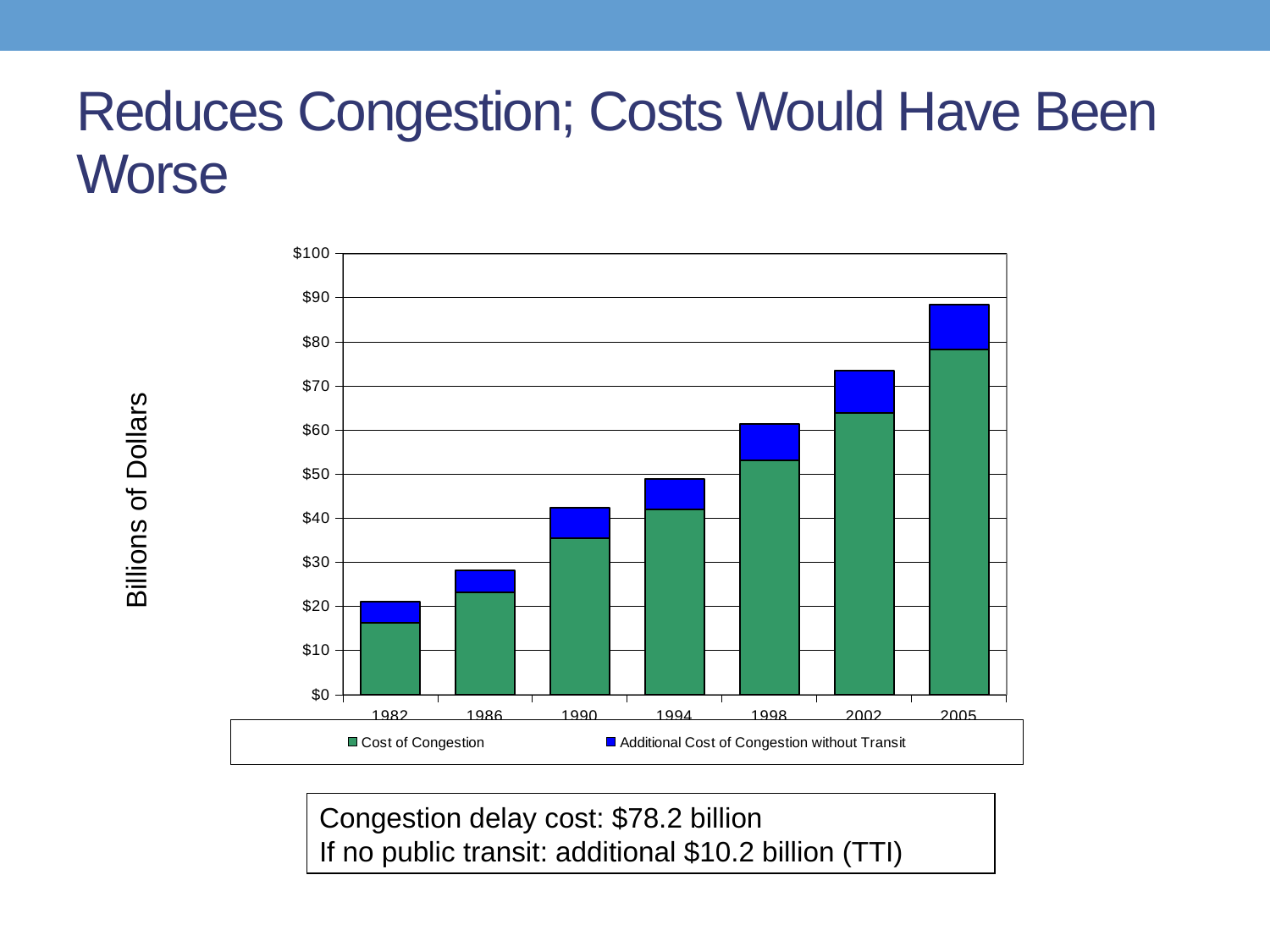
Which year has the larger stacked bar total, 1994 or 2002? 2002 What colour represents the Cost of Congestion series in the chart? green What kind of chart is shown on the slide? bar chart Is the total stacked bar for 1982 greater or less than $30? less Is the Cost of Congestion value for 1998 greater or less than $50? greater Is the total stacked bar for 2005 greater or less than $80? greater How many years are shown along the x axis of the chart? 7 What is the label on the chart's vertical axis? Billions of Dollars How many series does the chart's legend list? 2 Do the stacked bar totals rise or fall from 1982 to 2005? rise Which year has the shortest stacked bar? 1982 Which year has the tallest stacked bar? 2005